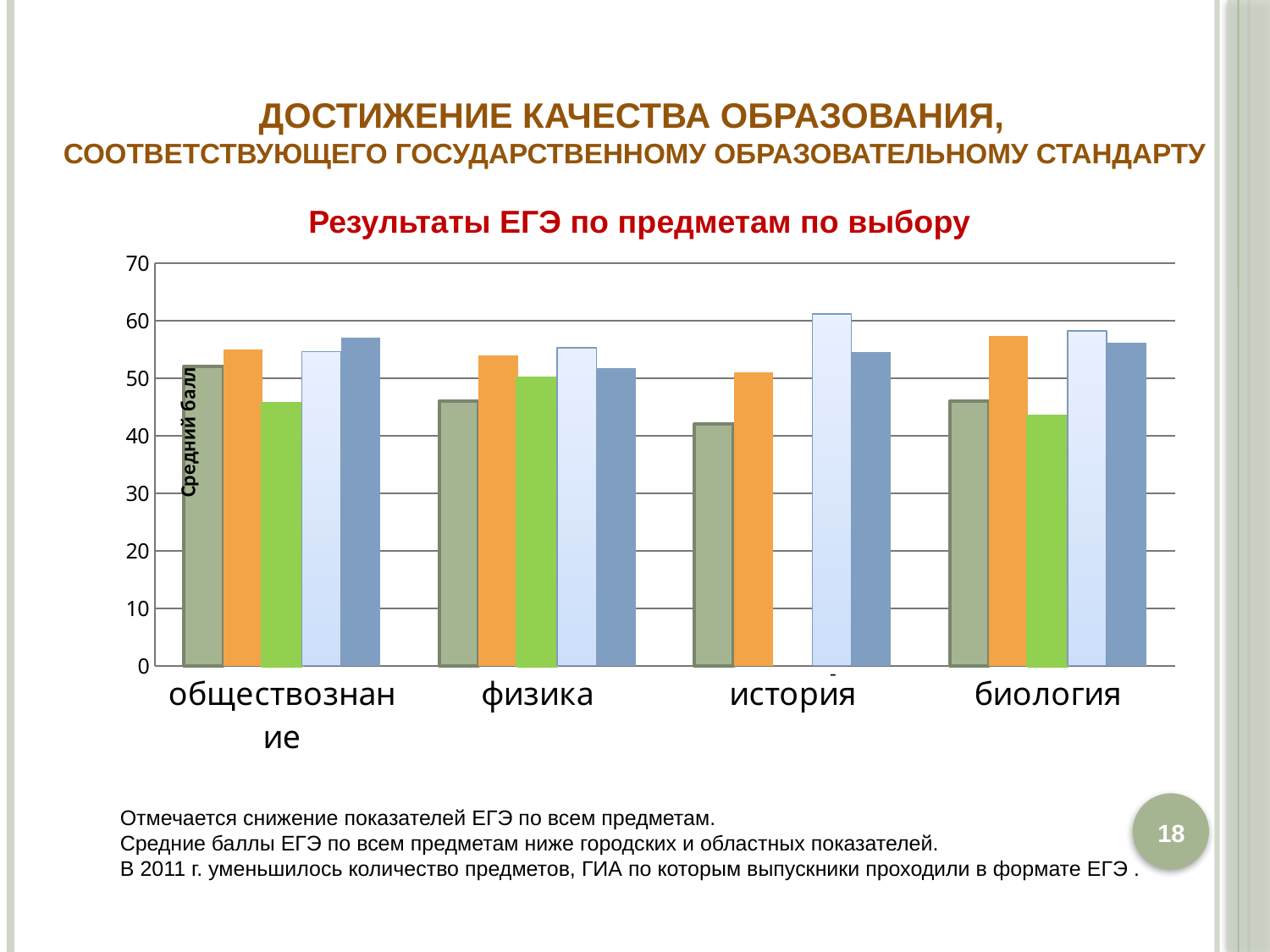
Which subject category contains the tallest bar in the chart? история Is the value of the orange bar for биология greater or less than 50? greater How many bars are plotted for the category история? 4 How many subject categories are shown on the x axis of the chart? 4 What is the title of the chart? Результаты ЕГЭ по предметам по выбору Which is larger: the first (grey) bar for обществознание or the first (grey) bar for история? обществознание What kind of chart is shown on the slide? bar chart Is the value of the first (grey) bar for история greater or less than 50? less Which is larger: the green bar for физика or the green bar for биология? физика Is the value of the first (grey) bar for физика greater or less than 50? less What is the label on the vertical axis of the chart? Средний балл